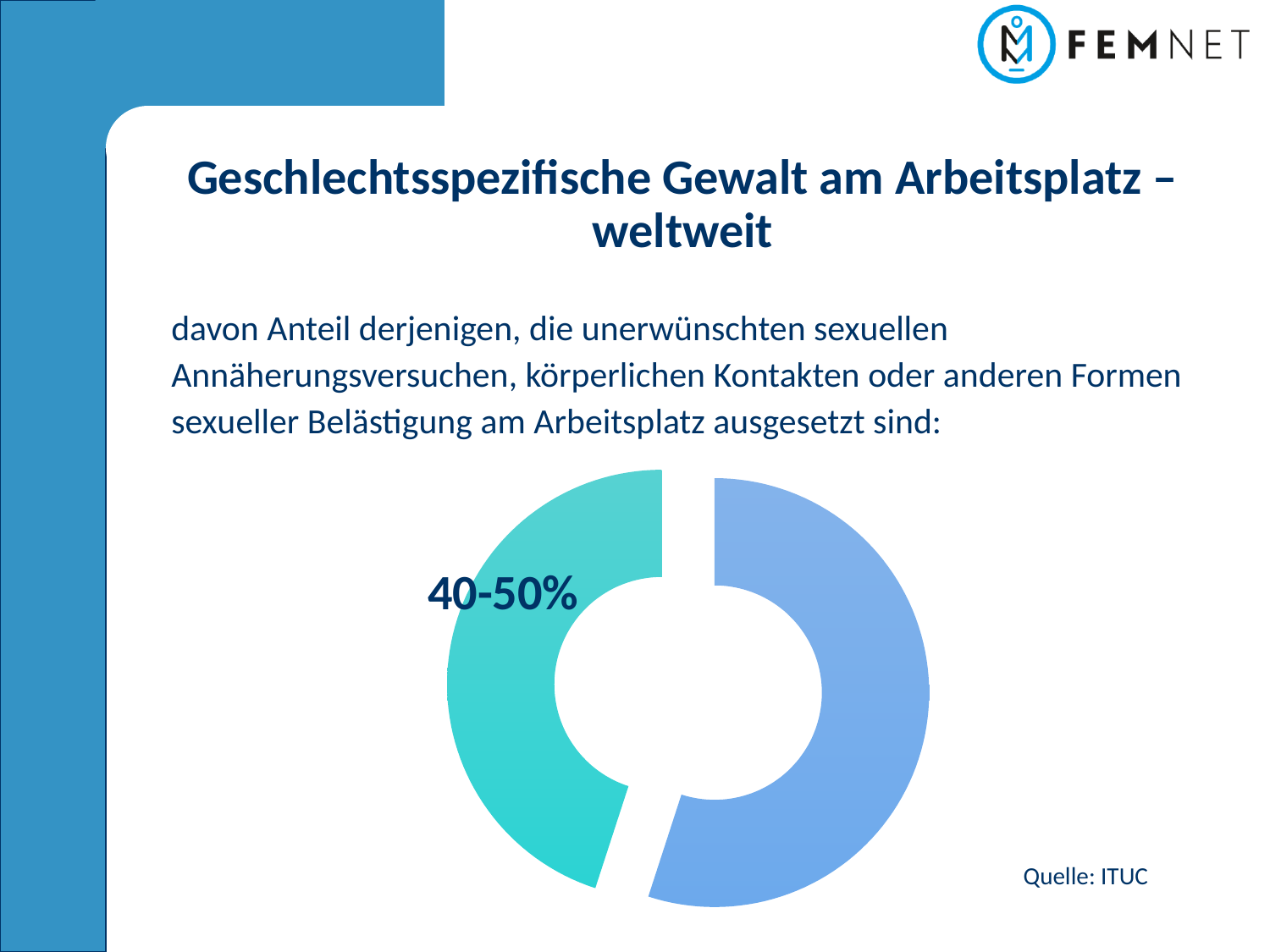
What kind of chart is shown on the slide? Pie chart (donut) Is the share of the teal slice labelled 40-50% greater or less than half of the donut? less Which slice of the donut chart is larger, the blue one or the teal one? The blue one What source is cited for the chart on the slide? ITUC How many slices does the donut chart have? 2 What value is printed on the teal slice of the donut chart? 40-50% What colour is the slice that carries the 40-50% label? Teal